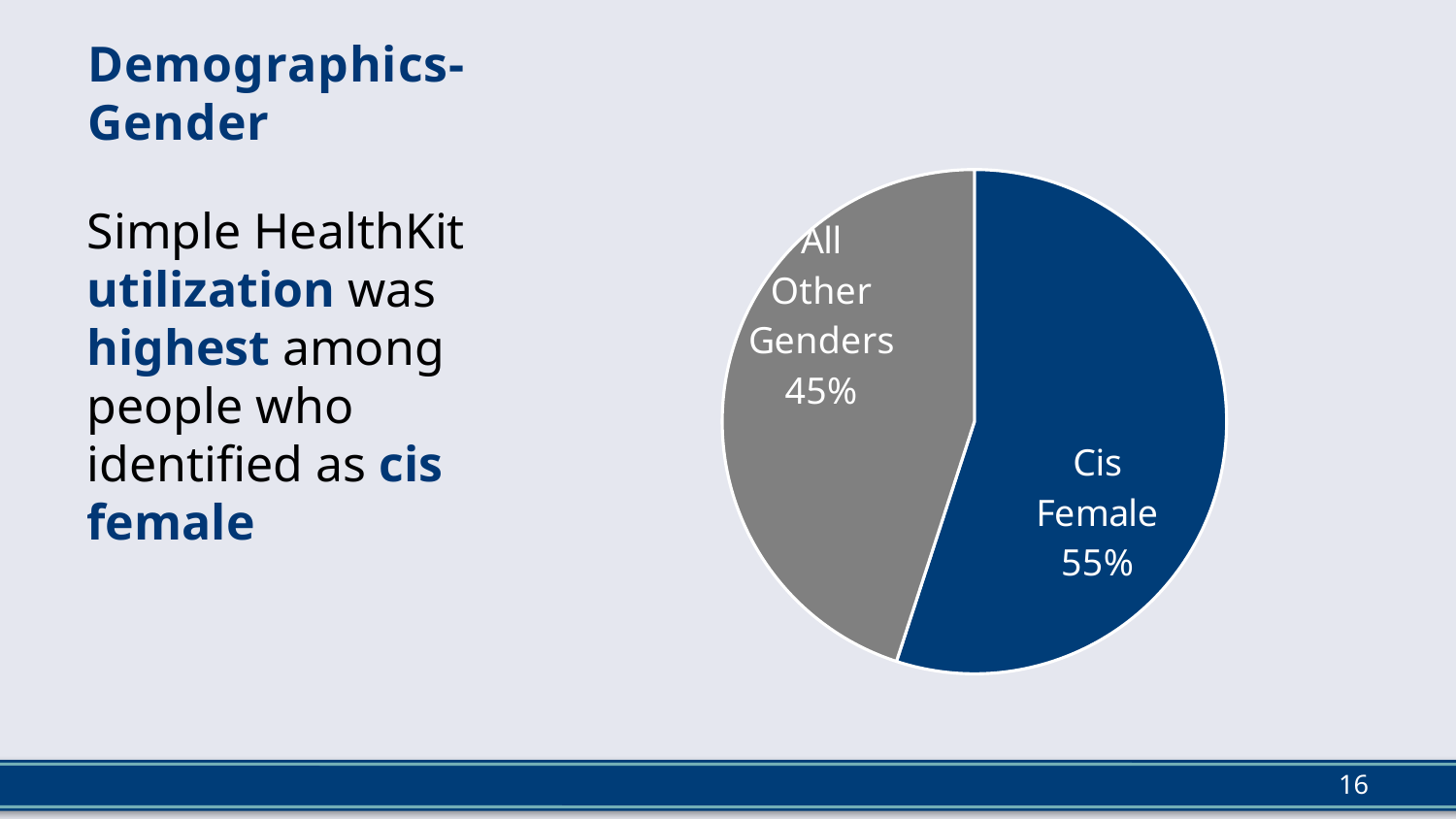
What is the difference in percentage points between the Cis Female slice and the All Other Genders slice? 10 What percentage of the pie is All Other Genders? 45% What share of the pie does the Cis Female slice represent? 55% Which is larger, the Cis Female slice or the All Other Genders slice? Cis Female Which slice of the pie is the largest? Cis Female What percentage of the pie is Cis Female? 55% What colour is the Cis Female slice? dark blue How many slices does the pie chart have? 2 Which slice of the pie is the smallest? All Other Genders What colour is the All Other Genders slice? grey What kind of chart is shown on the slide? pie chart